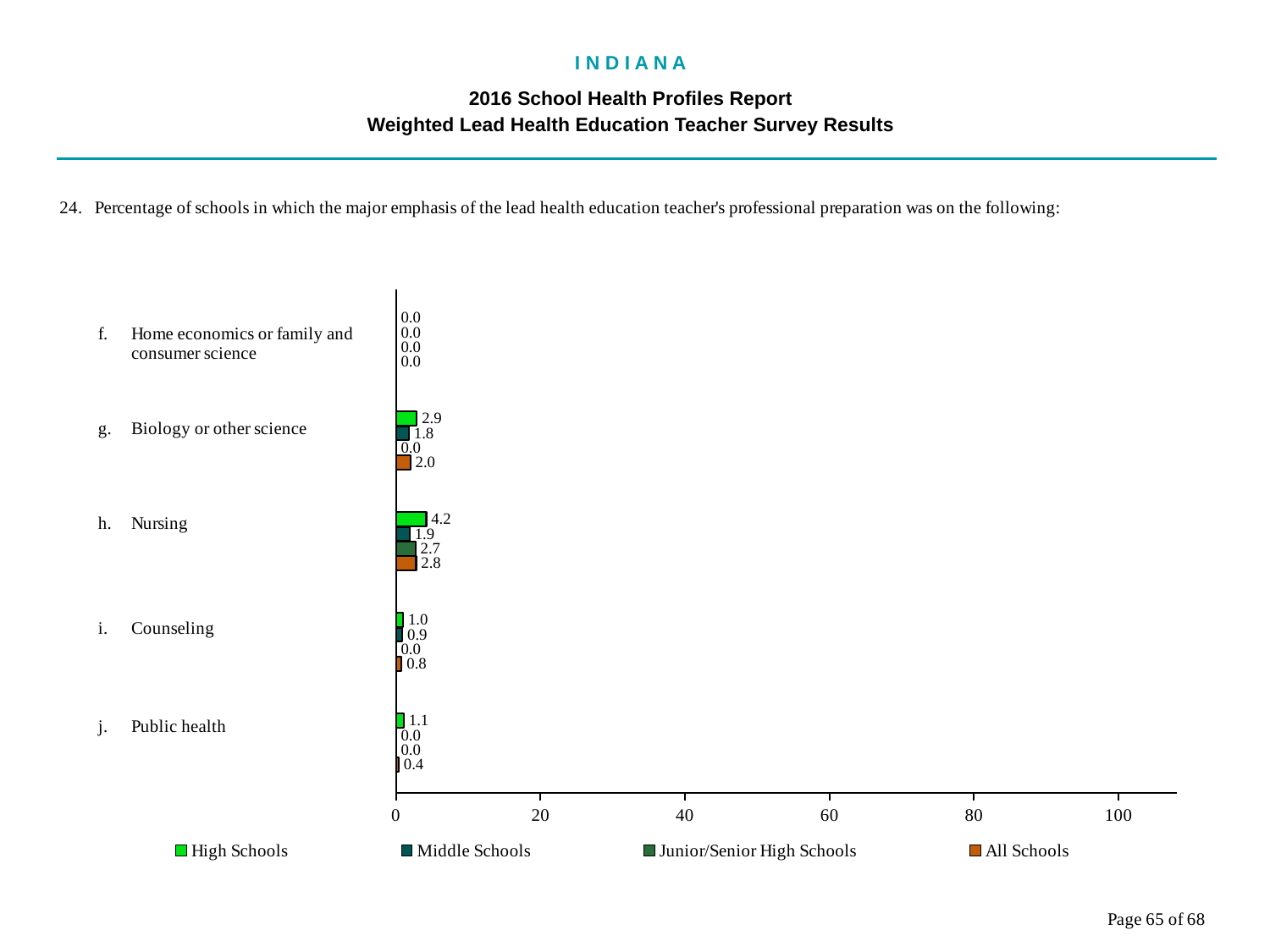
What is the value for Middle Schools in the Counseling category? 0.9 What is the value for All Schools in the Biology or other science category? 2.0 What is the value for All Schools in the Public health category? 0.4 Which is larger in the Biology or other science category: the High Schools value or the All Schools value? High Schools What is the value for High Schools in the Nursing category? 4.2 What kind of chart is shown on the slide? Bar chart What is the difference between the High Schools and Middle Schools values in the Nursing category? 2.3 How many series does the legend list? 4 Which category has the highest value for High Schools? Nursing What is the value for Junior/Senior High Schools in the Nursing category? 2.7 How many categories are shown on the chart? 5 Which series is shown in orange in the legend? All Schools